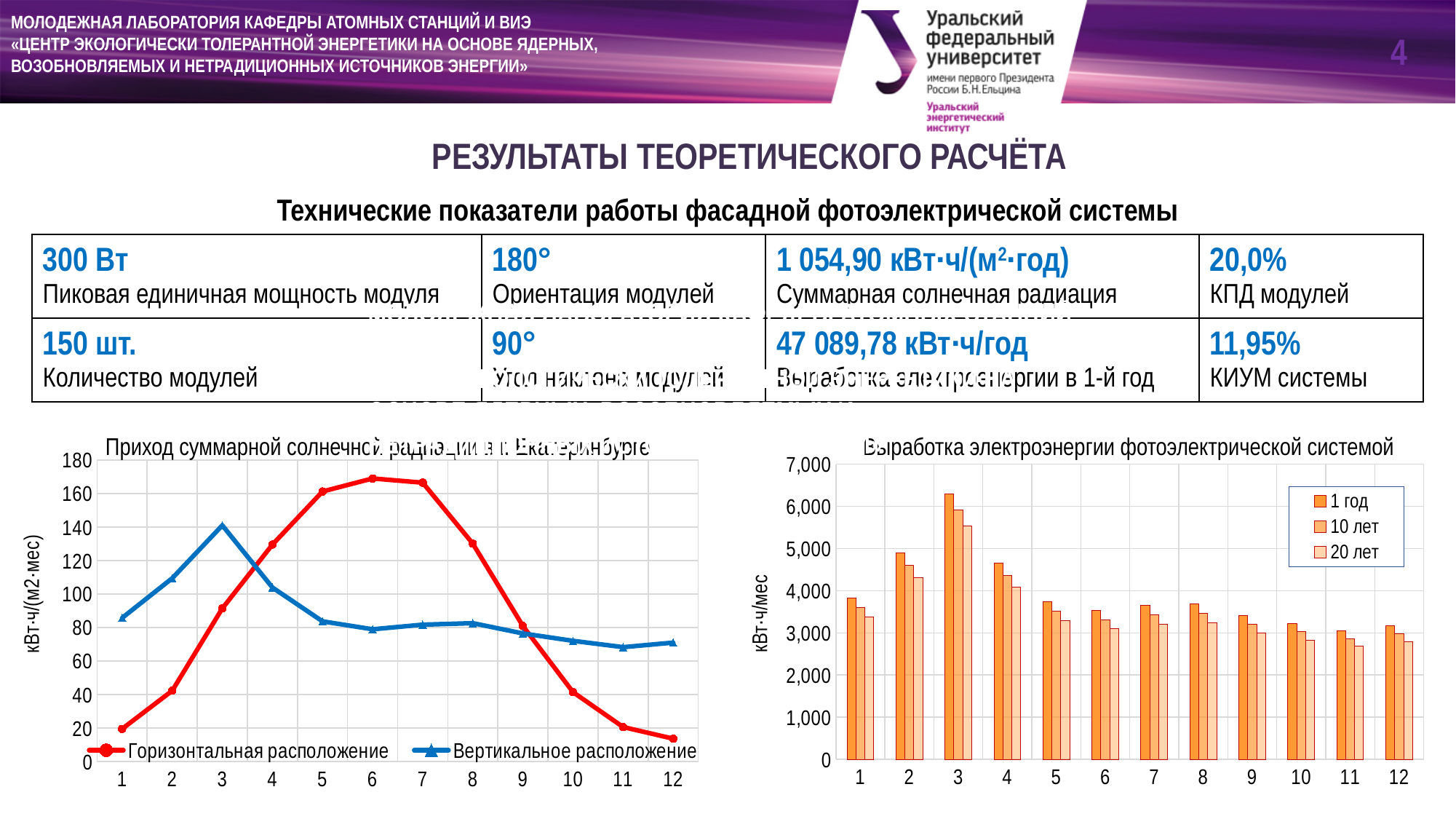
In the right chart 'Выработка электроэнергии фотоэлектрической системой', in which month is the '1 год' bar the tallest? 3 In the left chart 'Приход суммарной солнечной радиации в г. Екатеринбурге', is the value of 'Горизонтальная расположение' in month 6 greater or less than 160? greater In the left chart 'Приход суммарной солнечной радиации в г. Екатеринбурге', how many months are plotted on the x axis? 12 In the left chart 'Приход суммарной солнечной радиации в г. Екатеринбурге', how many series does the legend list? 2 In the right chart 'Выработка электроэнергии фотоэлектрической системой', which series has the larger value in month 3, '1 год' or '20 лет'? 1 год In the left chart 'Приход суммарной солнечной радиации в г. Екатеринбурге', in which month does the 'Горизонтальная расположение' series reach its highest value? 6 What kind of chart is the left chart titled 'Приход суммарной солнечной радиации в г. Екатеринбурге'? line chart In the left chart 'Приход суммарной солнечной радиации в г. Екатеринбурге', which series has the larger value in month 2, 'Горизонтальная расположение' or 'Вертикальное расположение'? Вертикальное расположение What kind of chart is the right chart titled 'Выработка электроэнергии фотоэлектрической системой'? bar chart In the right chart 'Выработка электроэнергии фотоэлектрической системой', is the '1 год' value in month 3 greater or less than 6,000? greater In the left chart 'Приход суммарной солнечной радиации в г. Екатеринбурге', in which month does the 'Вертикальное расположение' series reach its highest value? 3 In the right chart 'Выработка электроэнергии фотоэлектрической системой', how many series does the legend list? 3